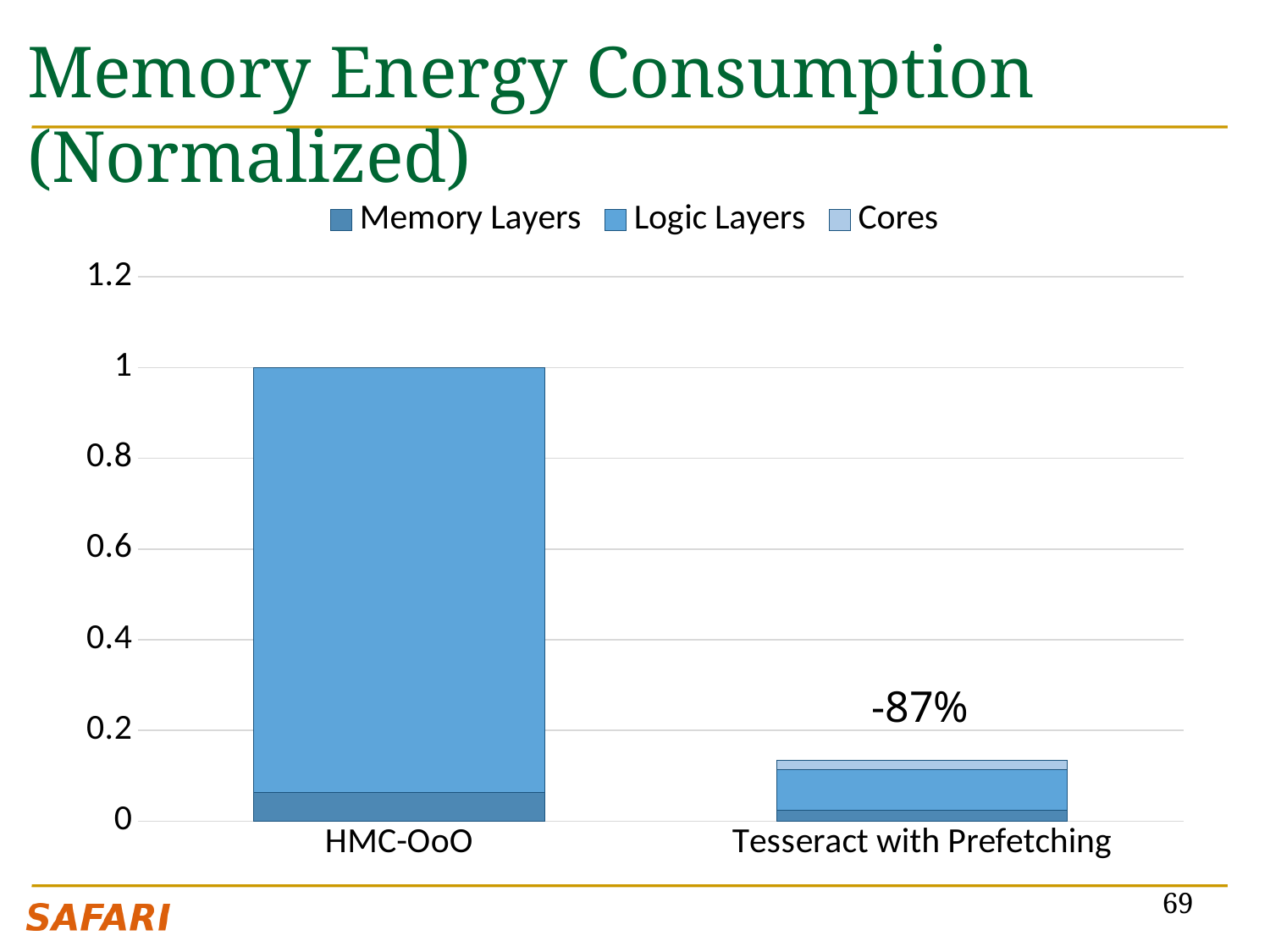
Which category has the lowest total normalized memory energy consumption? Tesseract with Prefetching What kind of chart is shown on the slide? bar chart Is the total value for Tesseract with Prefetching greater or less than 0.2? less Which category has the highest total normalized memory energy consumption? HMC-OoO Do the bar totals rise or fall from left to right along the x axis? fall What percentage change is annotated above the Tesseract with Prefetching bar? -87% Which has a larger total bar, HMC-OoO or Tesseract with Prefetching? HMC-OoO How many categories are shown on the x axis of the chart? 2 What are the three series named in the chart's legend? Memory Layers, Logic Layers, Cores How many series does the chart's legend list? 3 Is the total value for HMC-OoO greater or less than 0.8? greater What is the total height of the stacked bar for HMC-OoO? 1